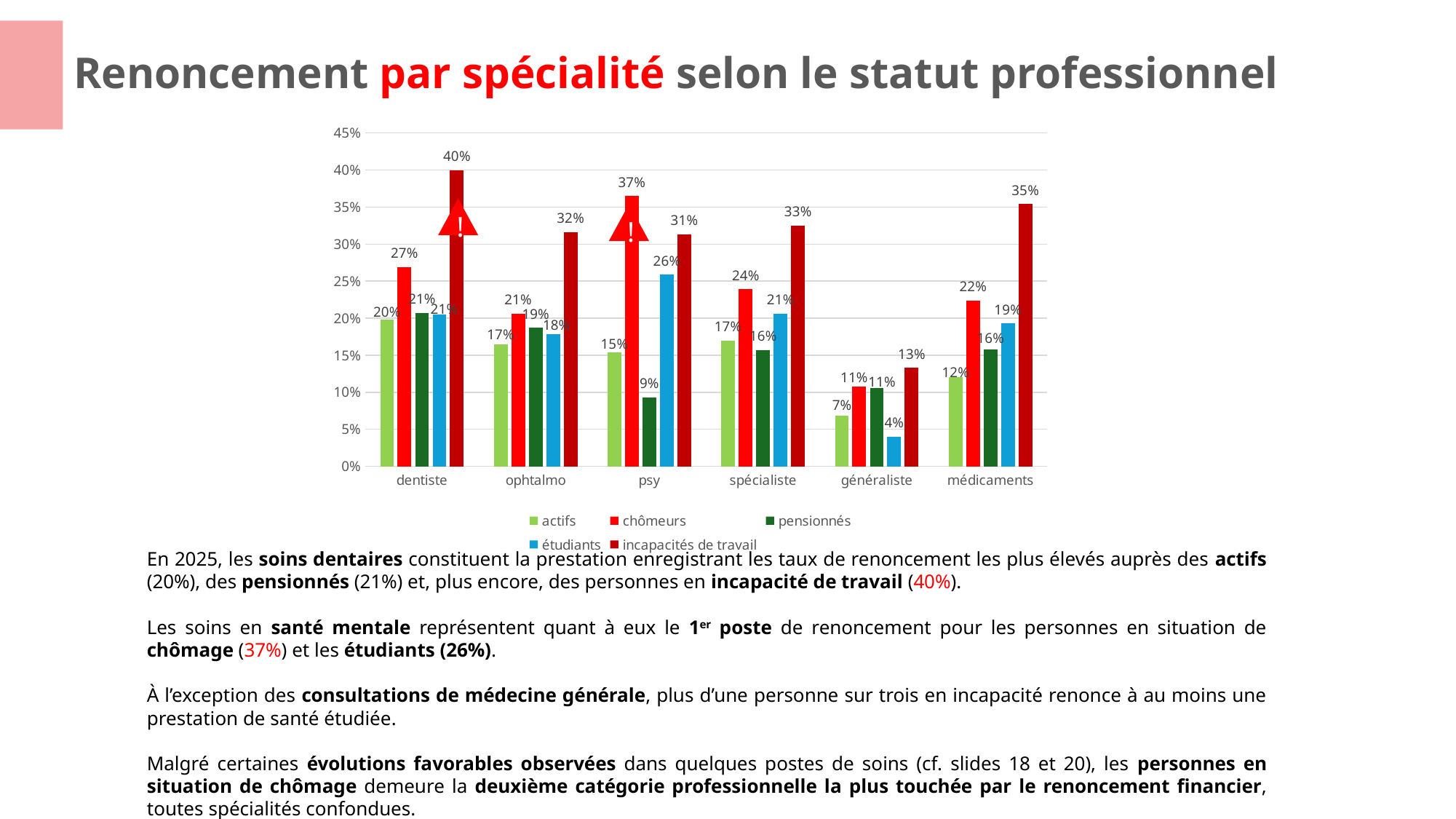
What kind of chart is shown on the slide? bar chart Which category has the highest value for the incapacités de travail series? dentiste What is the value for chômeurs in the psy category? 37% How many categories are shown on the x axis? 6 What is the difference between the chômeurs and actifs values in the psy category? 22% What is the value for étudiants in the généraliste category? 4% Which series is shown in blue in the legend? étudiants How many series does the legend list? 5 Which category has the lowest value for the actifs series? généraliste What is the value for pensionnés in the médicaments category? 16% What is the value for incapacités de travail in the dentiste category? 40% In the ophtalmo category, which is larger: the value for chômeurs or the value for étudiants? chômeurs